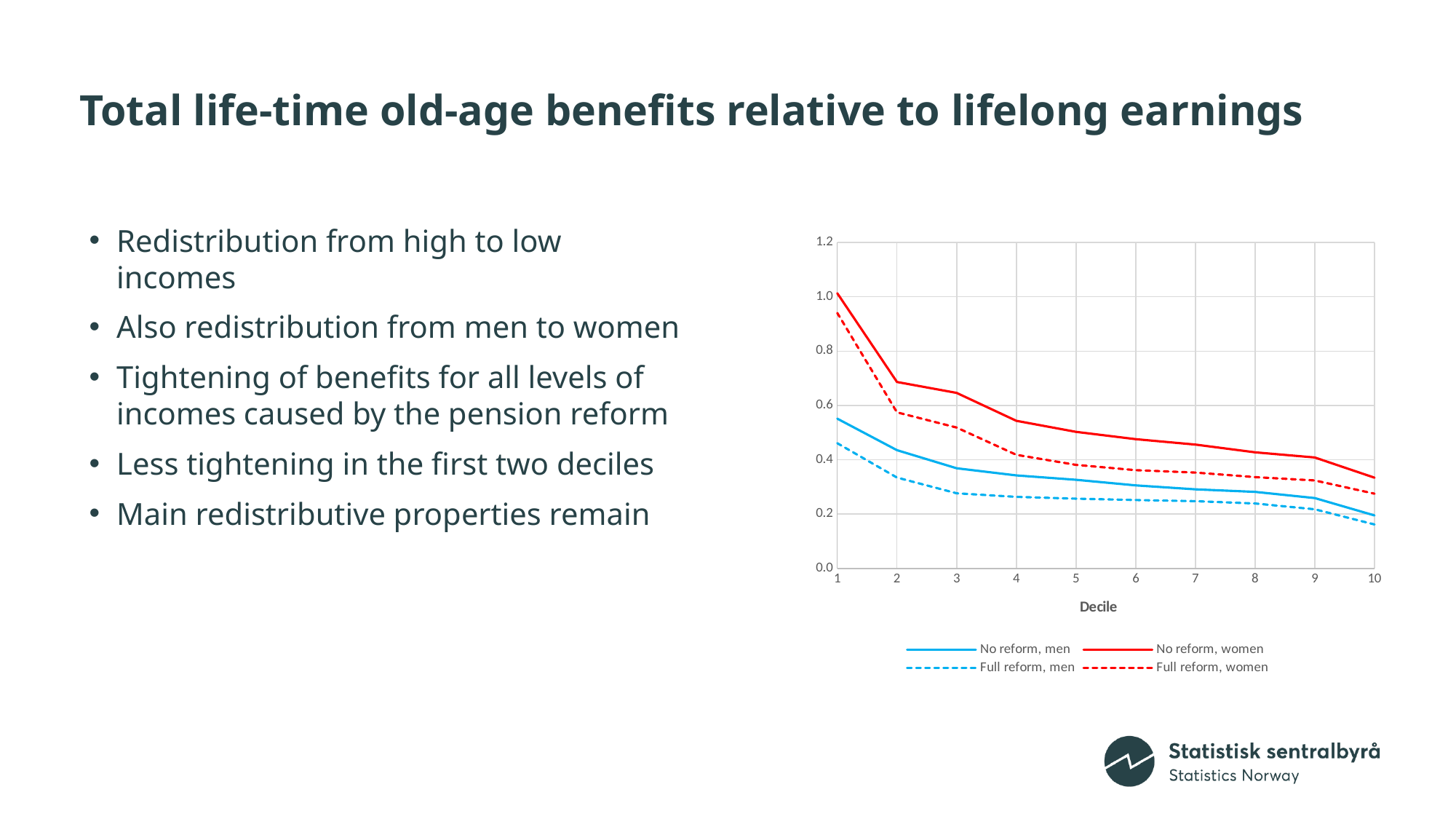
Is the value for 'No reform, men' at decile 1 greater or less than 0.6? less What kind of chart is shown on the slide? line chart How many deciles are plotted along the x axis? 10 Do the values for 'No reform, women' rise or fall as the decile increases? fall What is the title of the x axis? Decile At decile 5, which is larger: 'No reform, women' or 'No reform, men'? No reform, women At decile 3, which is larger: 'No reform, men' or 'Full reform, men'? No reform, men At which decile is the value for 'Full reform, women' lowest? 10 At which decile is the value for 'No reform, men' highest? 1 How many series does the legend list? 4 Is the value for 'Full reform, men' at decile 10 greater or less than 0.2? less Is the value for 'No reform, women' at decile 2 greater or less than 0.6? greater